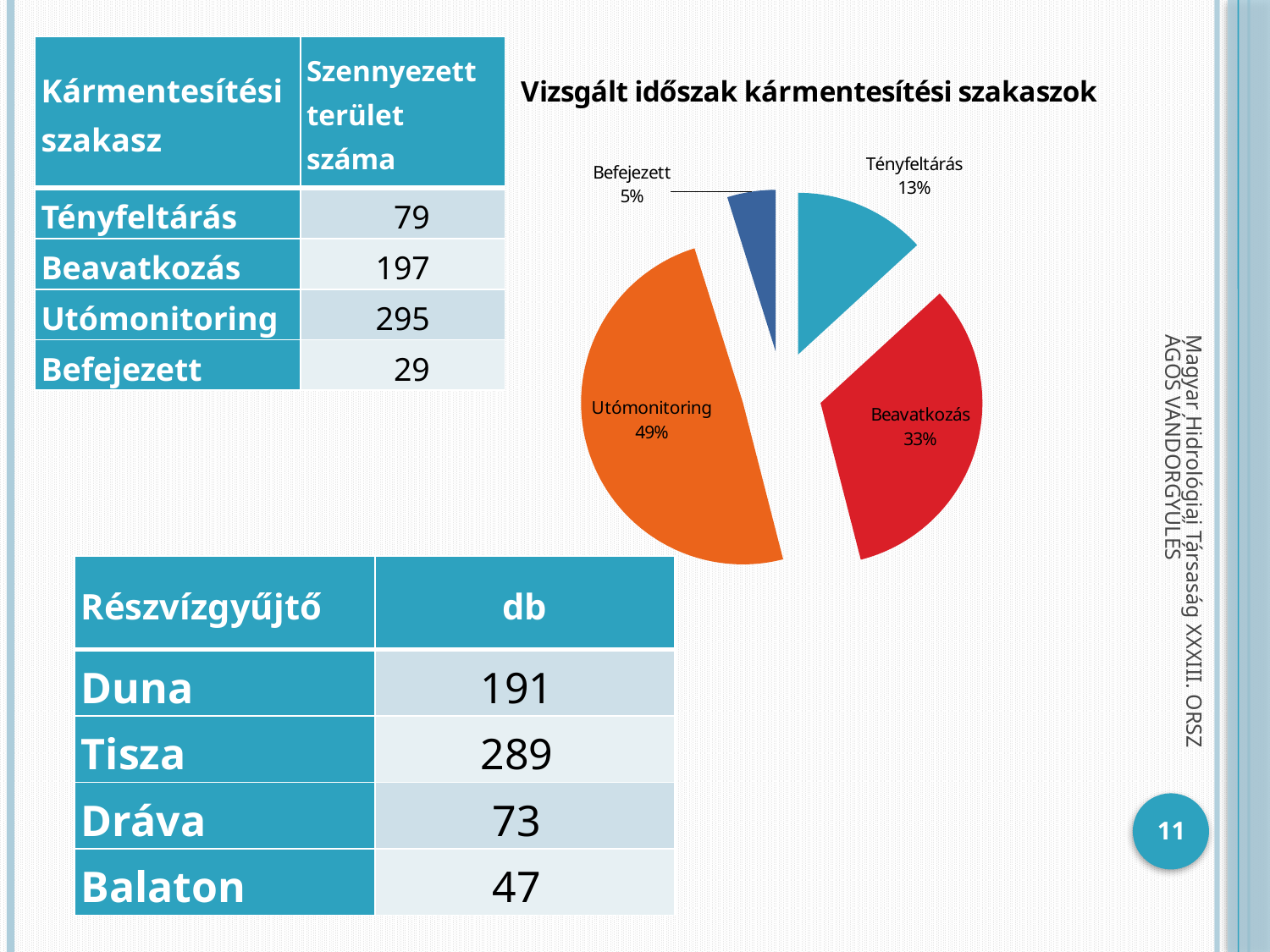
What is the difference in percentage points between the Utómonitoring and Beavatkozás slices? 16 How many slices does the pie chart have? 4 Which slice of the pie chart is the smallest? Befejezett What is the title of the pie chart? Vizsgált időszak kármentesítési szakaszok Which slice is larger in the pie chart, Beavatkozás or Tényfeltárás? Beavatkozás What colour is the Utómonitoring slice in the pie chart? orange Which slice of the pie chart is the largest? Utómonitoring What share of the pie does Beavatkozás have? 33% What share of the pie does Tényfeltárás have? 13% What share of the pie does Utómonitoring have? 49% What kind of chart is shown on the slide? pie chart